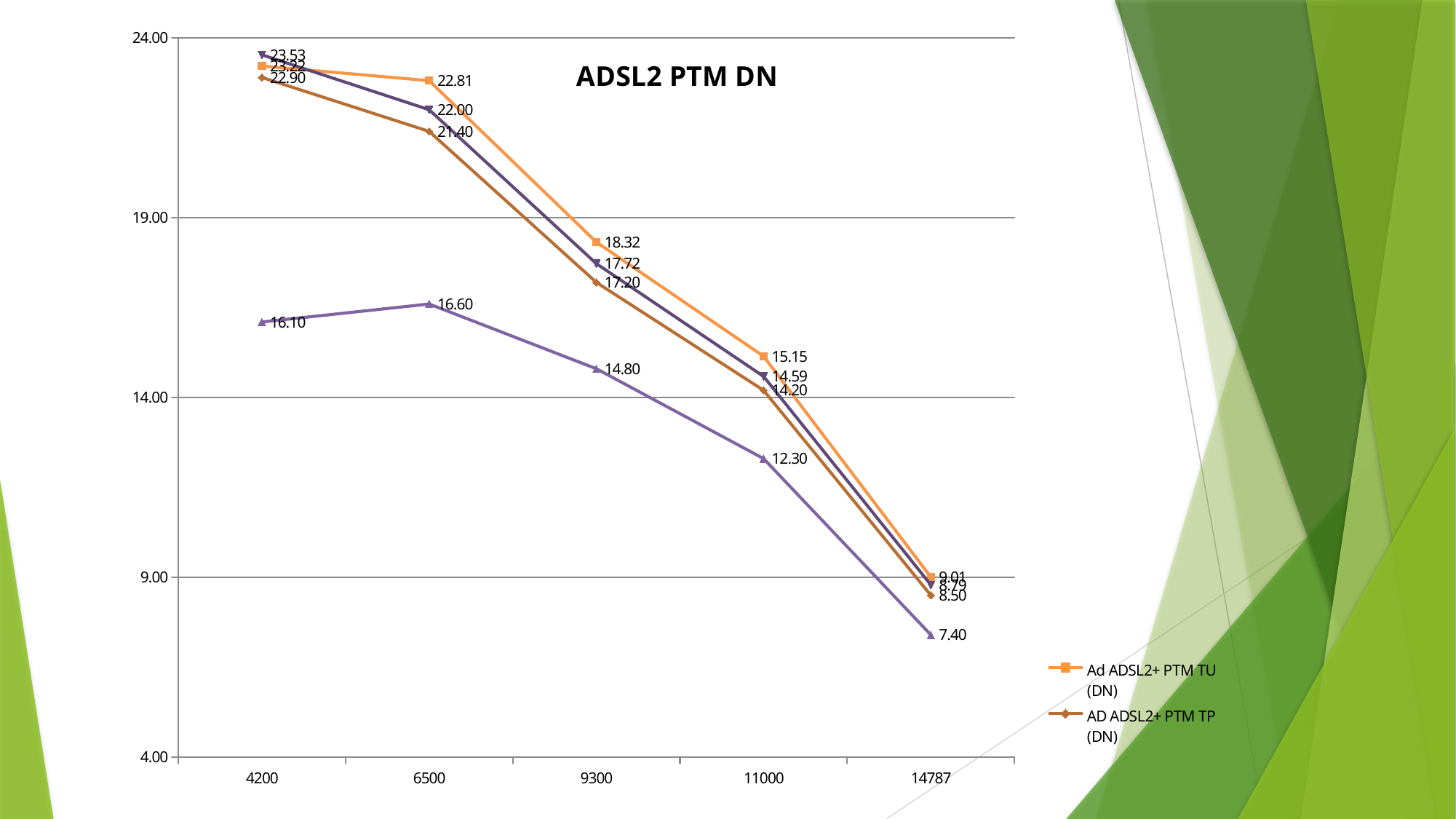
What is the title of the chart? ADSL2 PTM DN What is the value of the AD ADSL2+ PTM TP (DN) series at 6500? 21.40 At 9300, what is the difference between the Ad ADSL2+ PTM TU (DN) value and the AD ADSL2+ PTM TP (DN) value? 1.12 How many x-axis categories are plotted on the chart? 5 What is the value of the Ad ADSL2+ PTM TU (DN) series at 14787? 9.01 Do the values of the AD ADSL2+ PTM TP (DN) series rise or fall along the x axis? fall At 11000, which series has the larger value: Ad ADSL2+ PTM TU (DN) or AD ADSL2+ PTM TP (DN)? Ad ADSL2+ PTM TU (DN) At which x-axis category does the Ad ADSL2+ PTM TU (DN) series reach its lowest value? 14787 What kind of chart is shown on the slide? line chart What is the value of the Ad ADSL2+ PTM TU (DN) series at 9300? 18.32 At which x-axis category does the AD ADSL2+ PTM TP (DN) series reach its highest value? 4200 What is the value of the AD ADSL2+ PTM TP (DN) series at 11000? 14.20